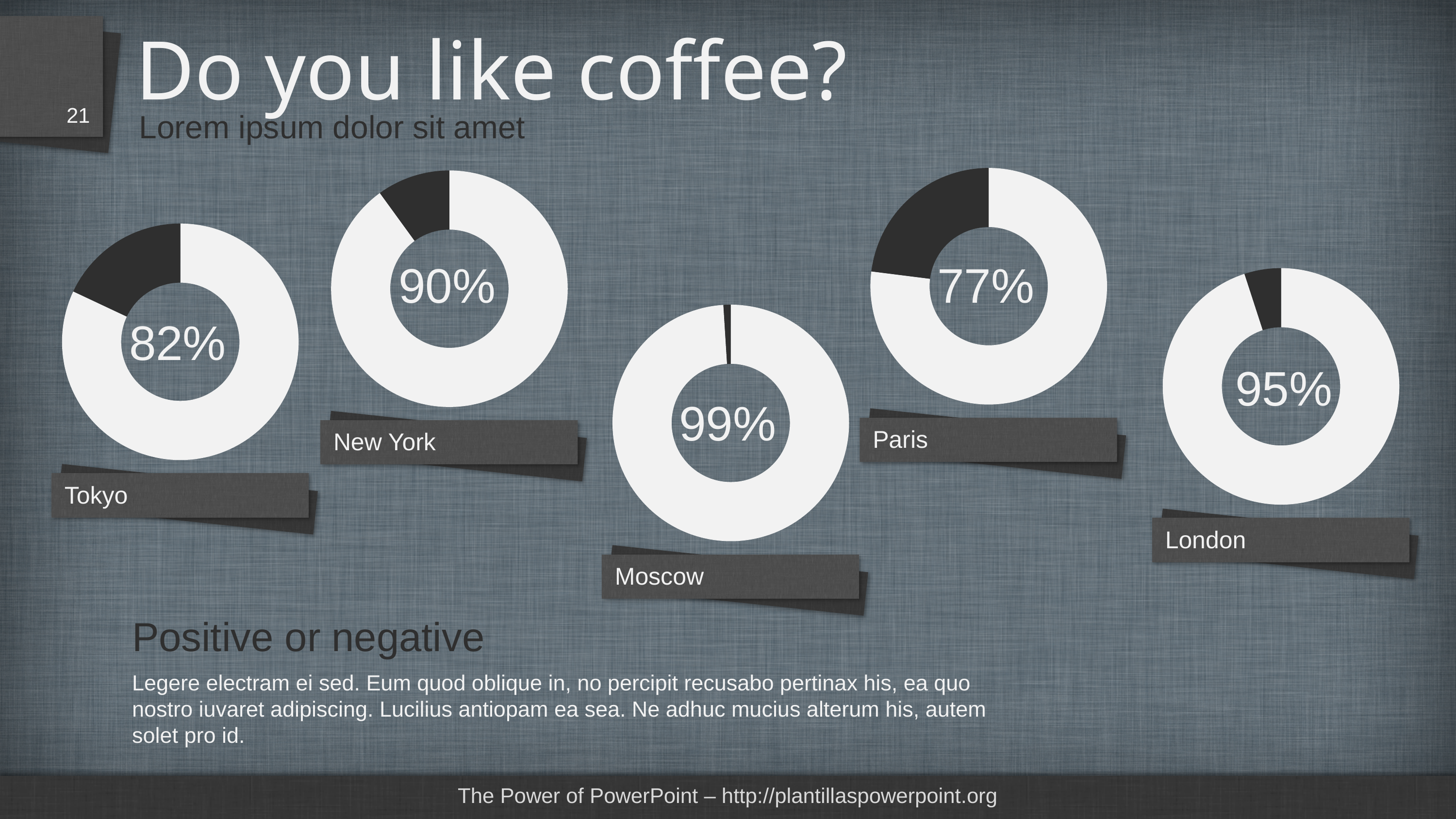
Which is larger, the Tokyo percentage or the New York percentage? New York What percentage is shown on the London chart? 95% What percentage is shown on the Tokyo chart? 82% What percentage is shown on the Paris chart? 77% Which city's chart shows the highest percentage? Moscow What percentage is shown on the Moscow chart? 99% Which is larger, the London percentage or the Paris percentage? London Which city's chart shows the lowest percentage? Paris What is the difference between the Moscow percentage and the Paris percentage? 22 percentage points What kind of chart is used for each city? Doughnut chart What percentage is shown on the New York chart? 90% How many city charts are shown on the slide? 5